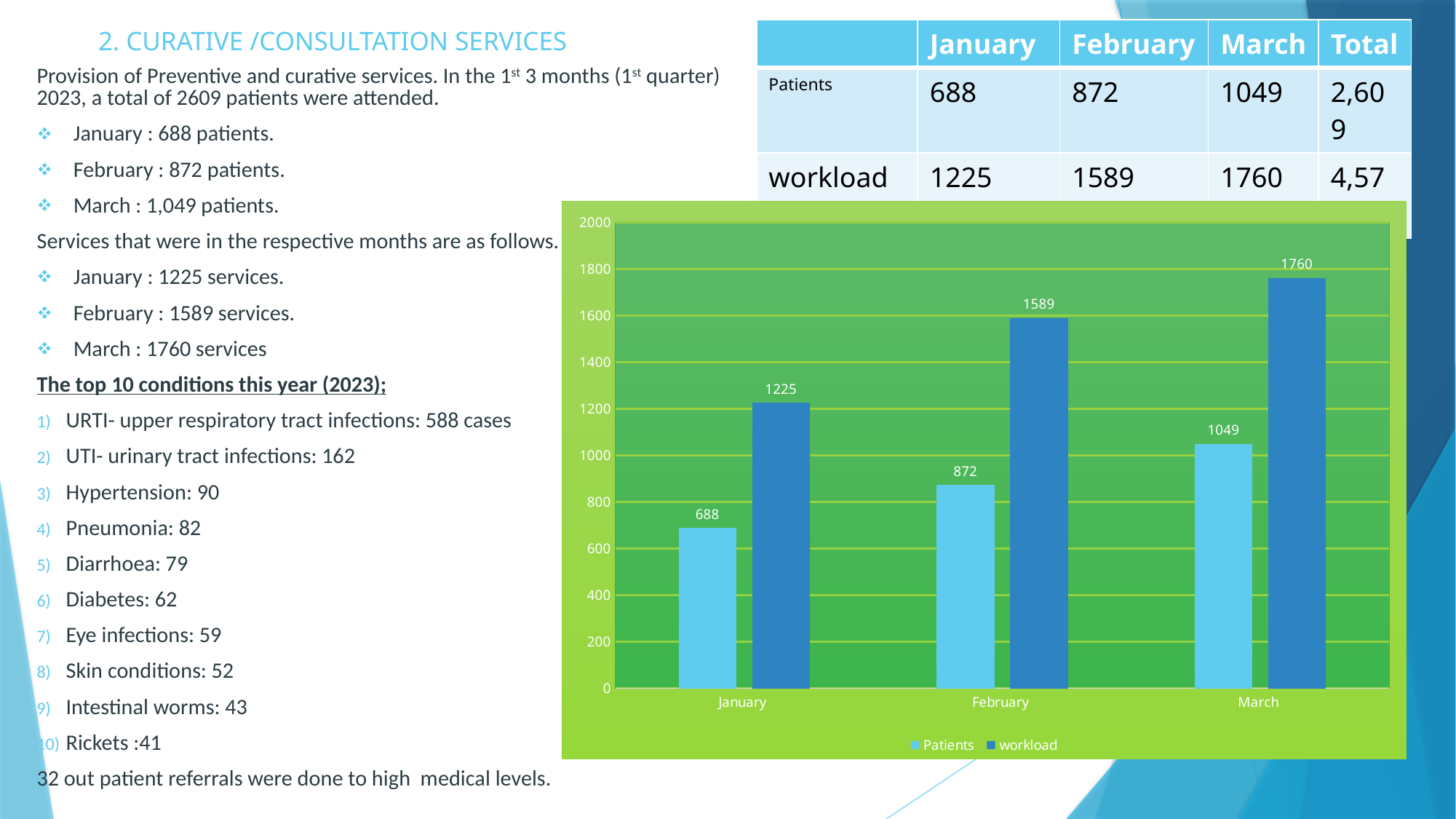
Is the workload value for February greater or less than 1400? greater What is the value for Patients in January? 688 How many series does the chart legend list? 2 Do the Patients values rise or fall from January to March? rise Which is larger: the Patients value for March or the workload value for January? workload value for January What is the difference between the workload and Patients values in February? 717 What is the workload value for March? 1760 What is the value for Patients in February? 872 What kind of chart is shown on the slide? bar chart Which month has the highest workload value? March Which month has the lowest Patients value? January How many months are shown on the x axis of the chart? 3